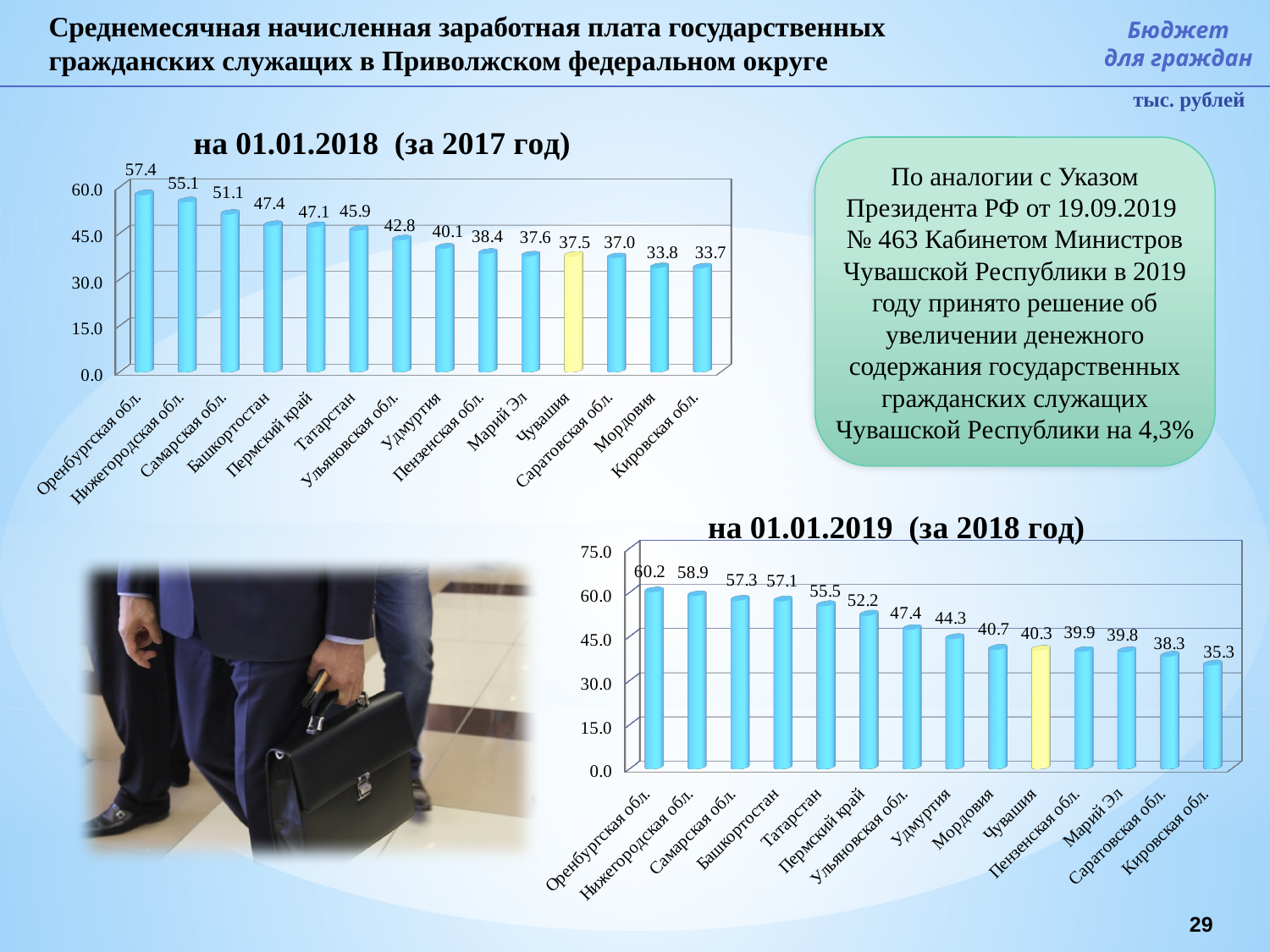
How many regions are shown in the chart 'на 01.01.2019 (за 2018 год)'? 14 In the chart 'на 01.01.2019 (за 2018 год)', which is larger: Удмуртия or Мордовия? Удмуртия In the chart 'на 01.01.2019 (за 2018 год)', do the values rise or fall from left to right? fall In the chart 'на 01.01.2019 (за 2018 год)', which region's bar is highlighted in yellow? Чувашия In the chart 'на 01.01.2019 (за 2018 год)', what is the difference between Оренбургская обл. and Кировская обл.? 24.9 In the chart 'на 01.01.2018 (за 2017 год)', is the value for Ульяновская обл. greater or less than 45.0? less What type of chart is 'на 01.01.2018 (за 2017 год)'? bar chart In the chart 'на 01.01.2018 (за 2017 год)', what is the difference between Чувашия and Мордовия? 3.7 In the chart 'на 01.01.2019 (за 2018 год)', which region has the lowest value? Кировская обл. In the chart 'на 01.01.2018 (за 2017 год)', what is the value for Чувашия? 37.5 In the chart 'на 01.01.2019 (за 2018 год)', what is the value for Татарстан? 55.5 In the chart 'на 01.01.2018 (за 2017 год)', which region has the highest value? Оренбургская обл.